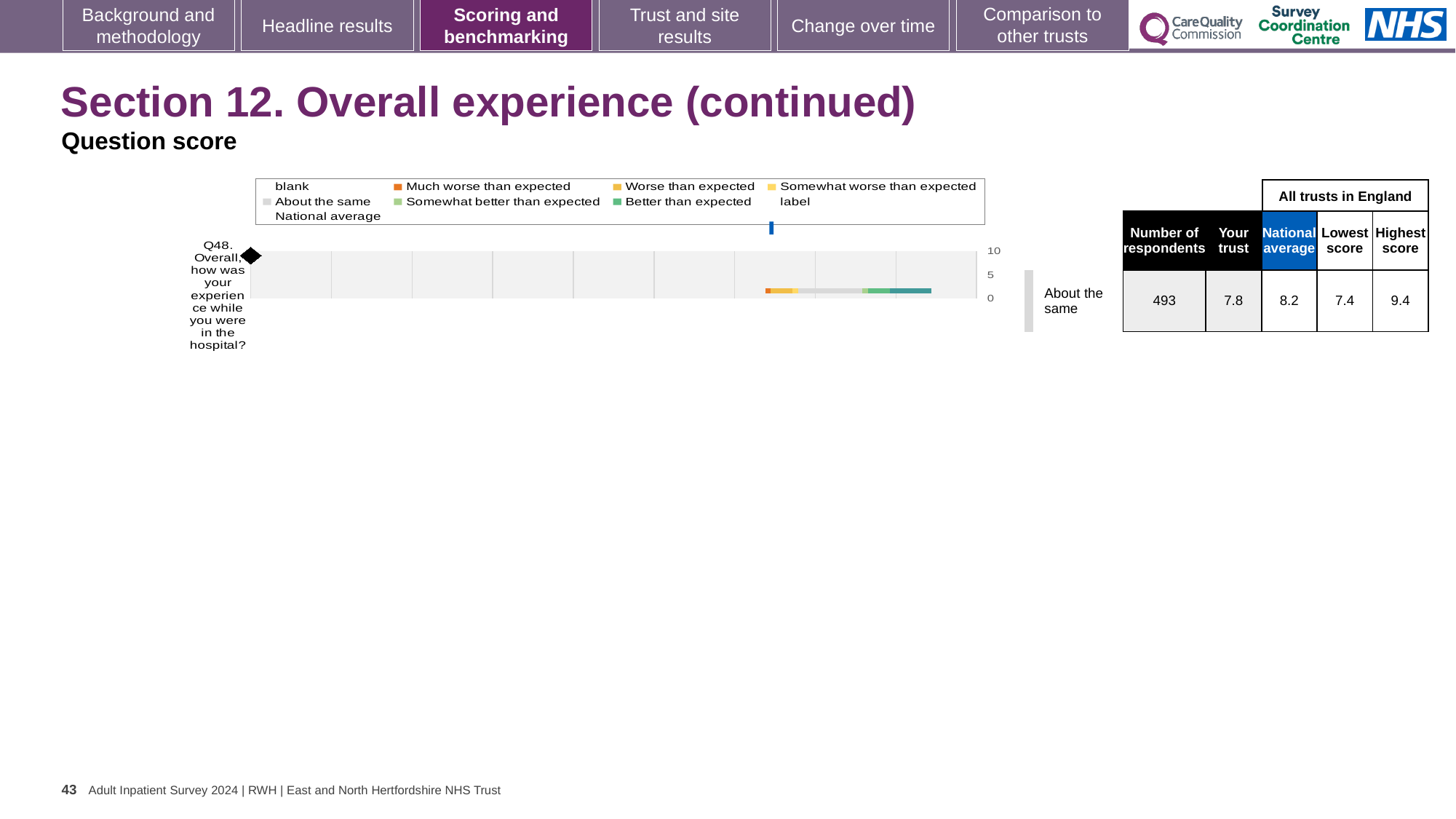
What is the lowest score among all trusts in England for Q48? 7.4 What is the difference between the national average and the 'Your trust' score for Q48? 0.4 What is the difference between the highest score and the lowest score for Q48? 2.0 What is the 'Your trust' score for Q48 in the table next to the chart? 7.8 How many respondents answered Q48? 493 Which is larger for Q48, the 'Your trust' score or the national average? National average What is the national average score for Q48 in the table next to the chart? 8.2 What kind of chart is shown on the slide? bar chart How many questions are plotted in the chart? 1 Which question is plotted in the chart? Q48. Overall, how was your experience while you were in the hospital? What is the highest value shown on the chart's axis? 10 What is the highest score among all trusts in England for Q48? 9.4